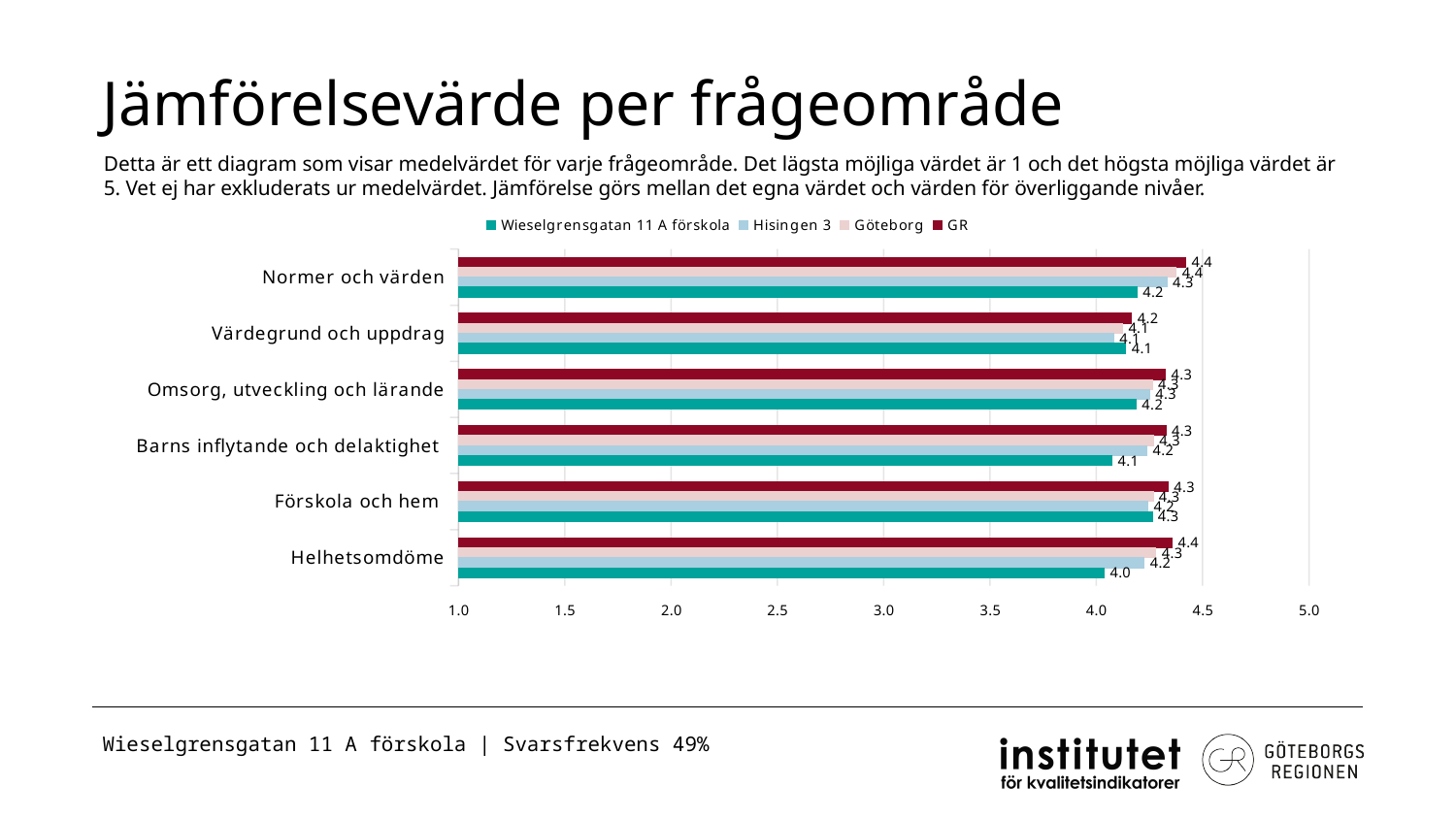
For which category does Wieselgrensgatan 11 A förskola have its highest value? Förskola och hem How many series does the legend list? 4 What kind of chart is shown on the slide? Bar chart How many categories (question areas) are shown on the chart? 6 What is the difference between the GR value and the Wieselgrensgatan 11 A förskola value for Helhetsomdöme? 0.4 What is the value for GR for Normer och värden? 4.4 Is the value for Wieselgrensgatan 11 A förskola for Helhetsomdöme greater or less than 4.5? less What is the value for GR for Värdegrund och uppdrag? 4.2 Which is larger for Barns inflytande och delaktighet: the GR value or the Wieselgrensgatan 11 A förskola value? GR For which category does Wieselgrensgatan 11 A förskola have its lowest value? Helhetsomdöme What is the value for Wieselgrensgatan 11 A förskola for Helhetsomdöme? 4.0 What is the value for Wieselgrensgatan 11 A förskola for Förskola och hem? 4.3